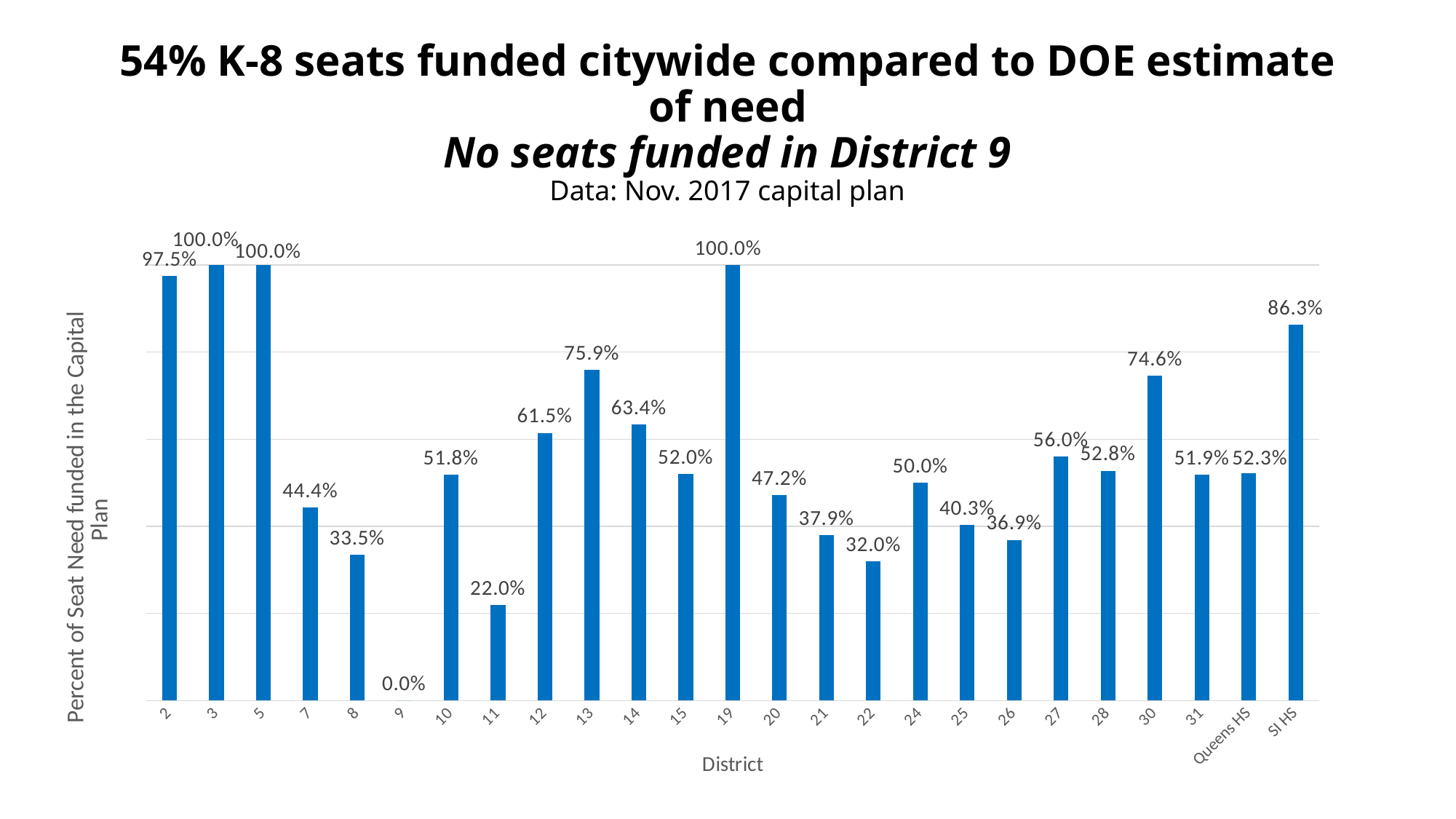
What is the difference between the values for District 2 and District 8? 64.0% Which districts have 100.0% of seat need funded? Districts 3, 5 and 19 What percent of seat need is funded for District 11? 22.0% Which has a higher percent of seat need funded, District 12 or District 14? District 14 How many districts or categories are shown on the x axis? 25 What percent of seat need is funded in the capital plan for District 13? 75.9% Which district has the lowest percent of seat need funded? District 9 What is the difference between the values for District 30 and District 31? 22.7% What is the value shown for SI HS? 86.3% What is the label of the y axis? Percent of Seat Need funded in the Capital Plan What kind of chart is shown on the slide? Bar chart What is the value shown for District 9? 0.0%